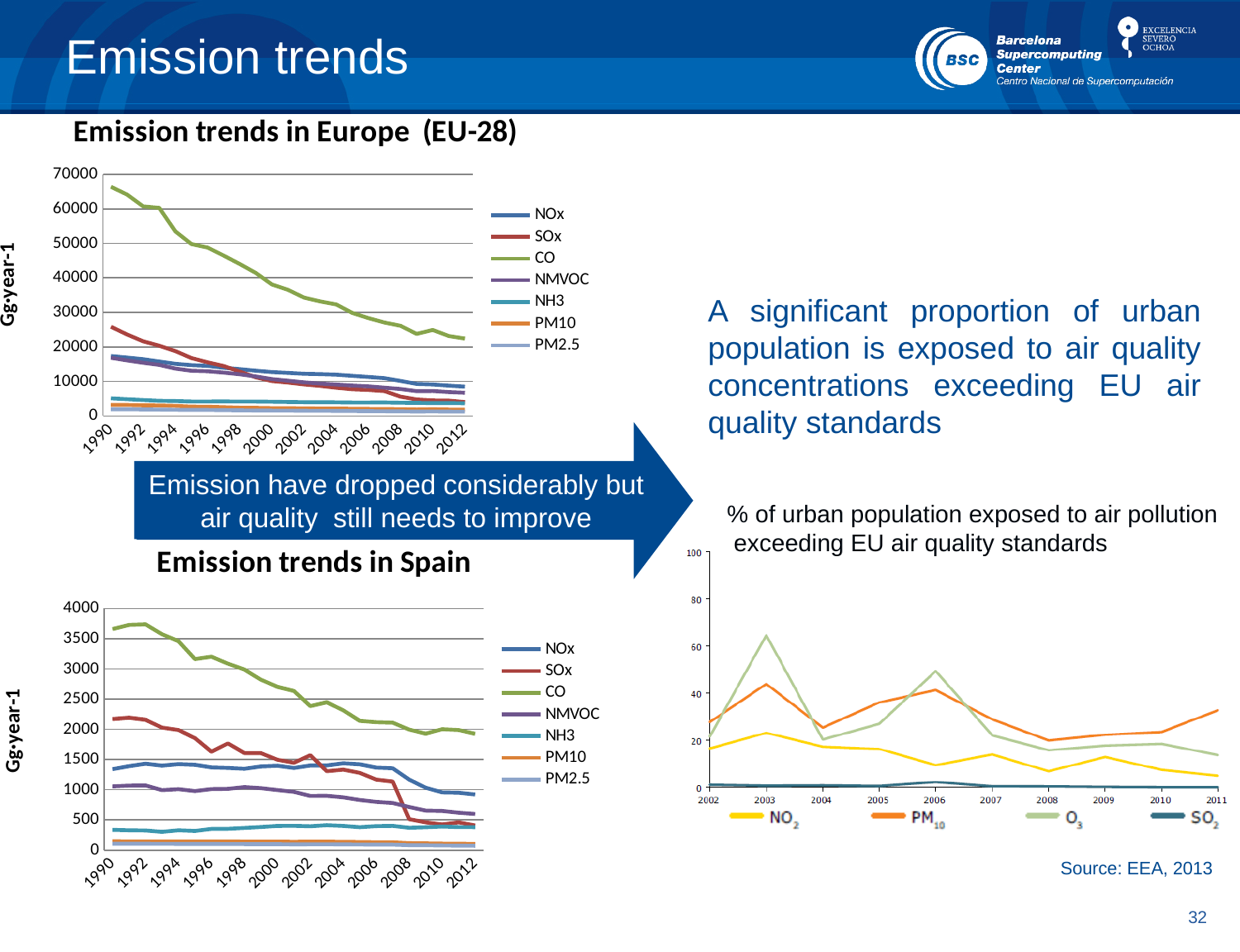
In the 'Emission trends in Spain' chart, which is larger in 1990, NOx or NMVOC? NOx What is the y-axis label of the 'Emission trends in Spain' chart? Gg·year-1 In the 'Emission trends in Spain' chart, is the NOx value in 2012 greater or less than 1000? less How many series does the legend of the '% of urban population exposed to air pollution exceeding EU air quality standards' chart list? 4 In the '% of urban population exposed to air pollution exceeding EU air quality standards' chart, which pollutant has the lowest values across all years? SO2 In the 'Emission trends in Europe (EU-28)' chart, is the CO value in 1990 greater or less than 60000? greater What kind of chart is the 'Emission trends in Europe (EU-28)' chart? line chart In the 'Emission trends in Europe (EU-28)' chart, do CO emissions rise or fall from 1990 to 2012? fall How many series does the legend of the 'Emission trends in Europe (EU-28)' chart list? 7 In the 'Emission trends in Europe (EU-28)' chart, which pollutant has the highest emissions throughout the period? CO In the 'Emission trends in Spain' chart, is the CO value in 1990 greater or less than 3500? greater